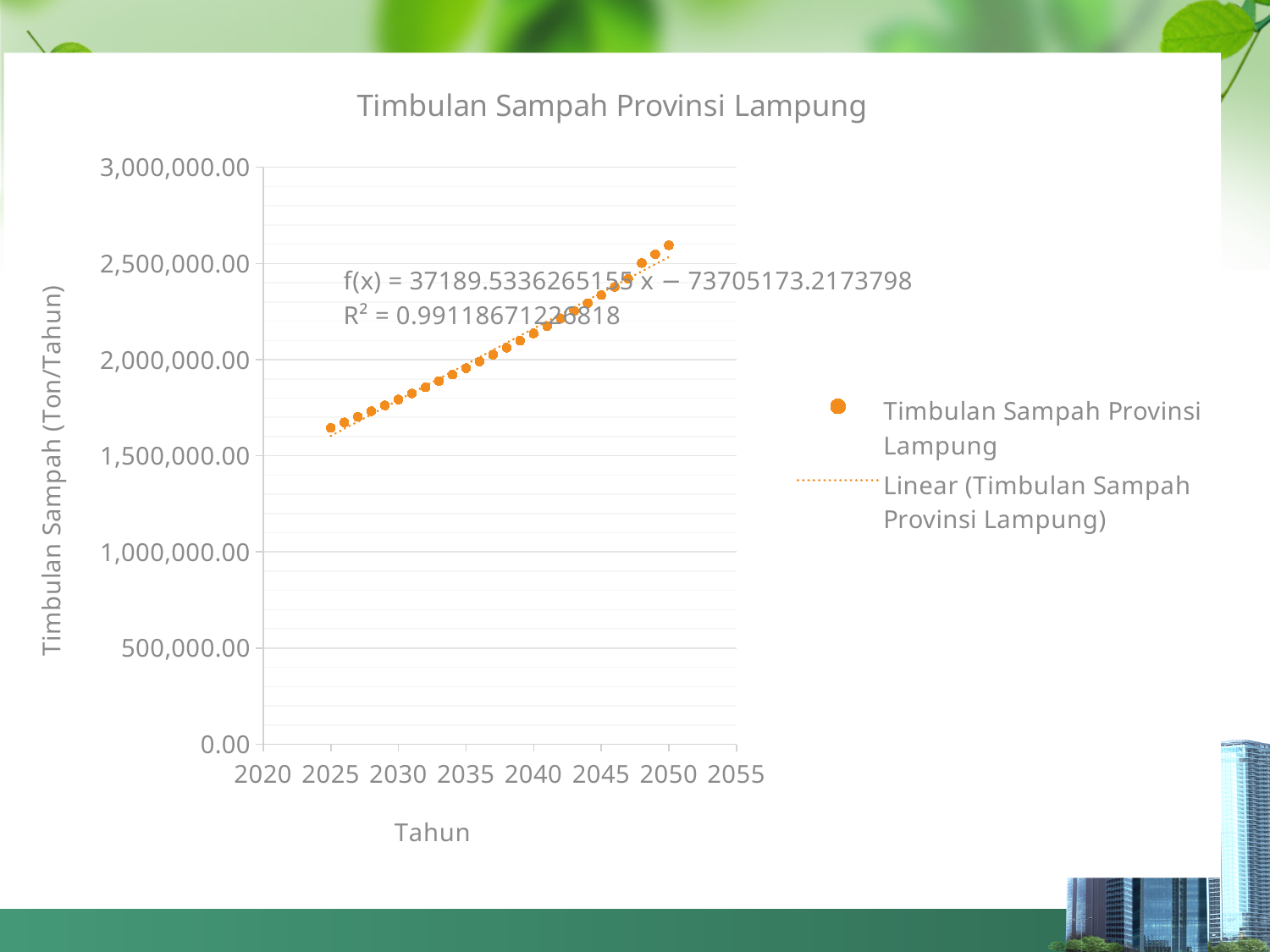
Which year has the higher value, 2025 or 2050? 2050 Which year has the lowest plotted value? 2025 What is the title of the chart? Timbulan Sampah Provinsi Lampung Is the value for 2025 greater or less than 1,500,000.00? greater What is the label of the x axis? Tahun Is the value for 2050 greater or less than 2,500,000.00? greater Which year has the highest plotted value? 2050 How many entries does the legend list? 2 What kind of chart is shown on the slide? Scatter chart Do the plotted values rise or fall as the year increases along the x axis? Rise Is the value for 2040 greater or less than 2,500,000.00? less